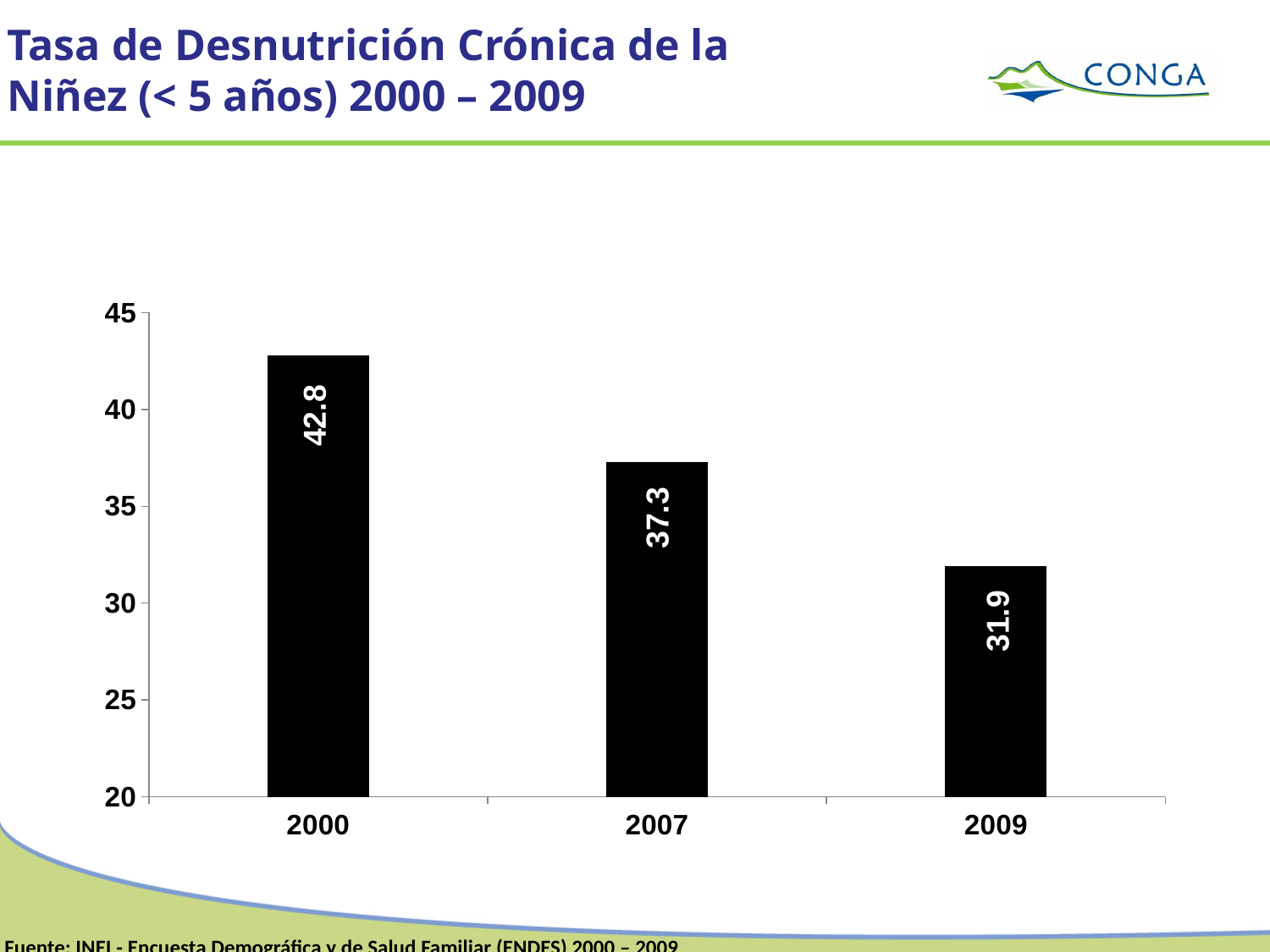
Which year has the lowest value? 2009 What is the value for 2007? 37.3 Do the values rise or fall from 2000 to 2009? fall What is the difference between the values for 2000 and 2009? 10.9 Which is larger, the value for 2007 or the value for 2009? 2007 What kind of chart is shown? bar chart What is the value for 2009? 31.9 What is the value for 2000? 42.8 Is the value for 2007 greater or less than 40? less What is the difference between the values for 2007 and 2009? 5.4 How many years are shown on the x axis? 3 Which year has the highest value? 2000